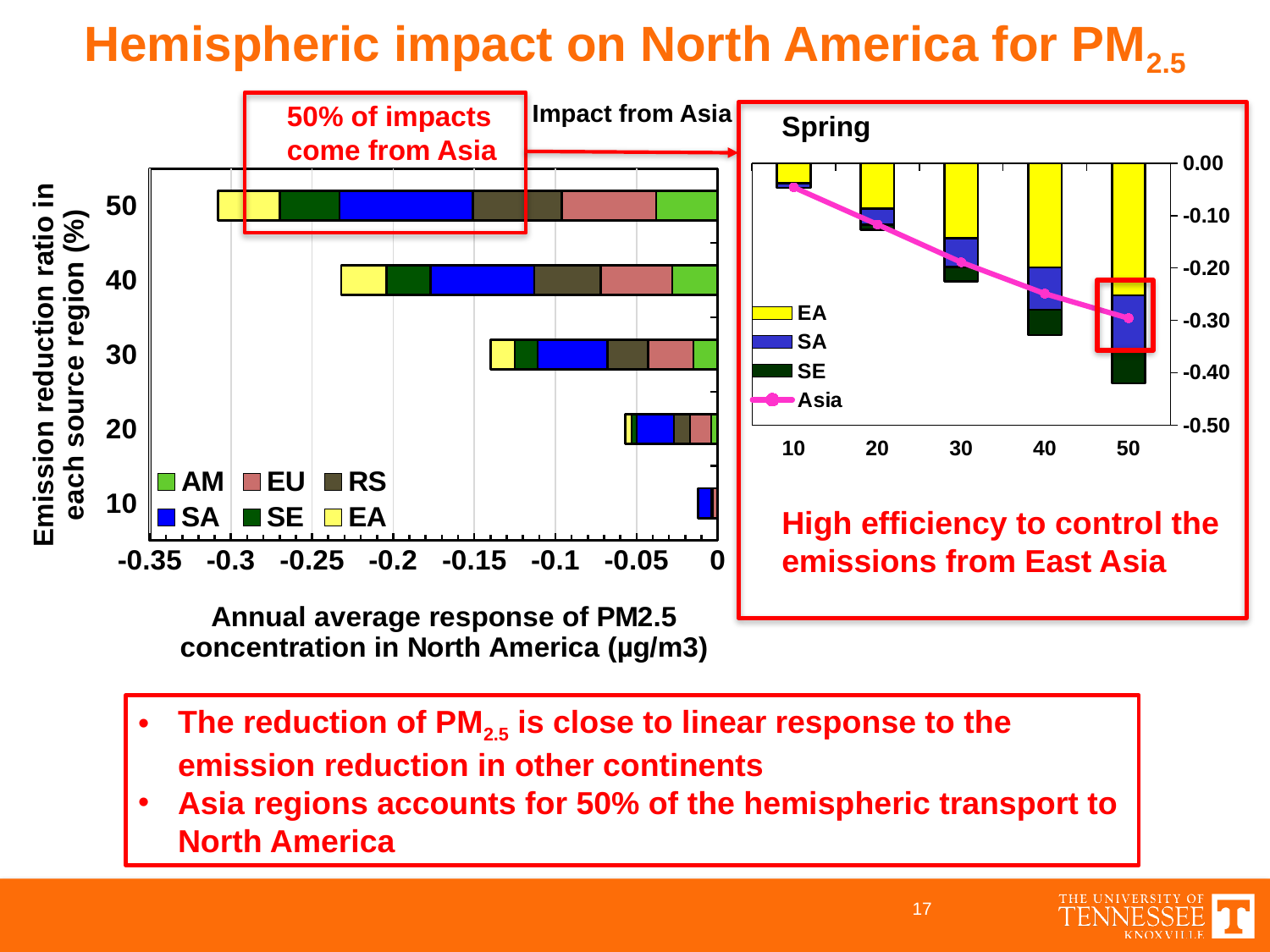
How many emission reduction ratio categories are plotted on the left chart (annual average response of PM2.5)? 5 How many entries does the legend of the Spring chart list? 4 On the left chart (annual average response of PM2.5), which emission reduction ratio has the longest stacked bar? 50 On the Spring chart, which x-axis category has the tallest stacked bar? 50 On the Spring chart, how does the Asia line change as the x-axis value increases from 10 to 50? It falls (becomes more negative) On the left chart (annual average response of PM2.5), is the stacked bar for 40 longer or shorter than the bar for 30? Longer On the left chart (annual average response of PM2.5), does the stacked bar for 50 extend past -0.3 on the x axis? Yes How many series does the legend of the left chart (annual average response of PM2.5) list? 6 On the left chart (annual average response of PM2.5), which emission reduction ratio has the shortest stacked bar? 10 What is the x-axis title of the left chart? Annual average response of PM2.5 concentration in North America (μg/m3) What is the title of the chart on the right side of the slide? Spring What kind of chart is the left chart showing the annual average response of PM2.5 concentration in North America? Stacked bar chart